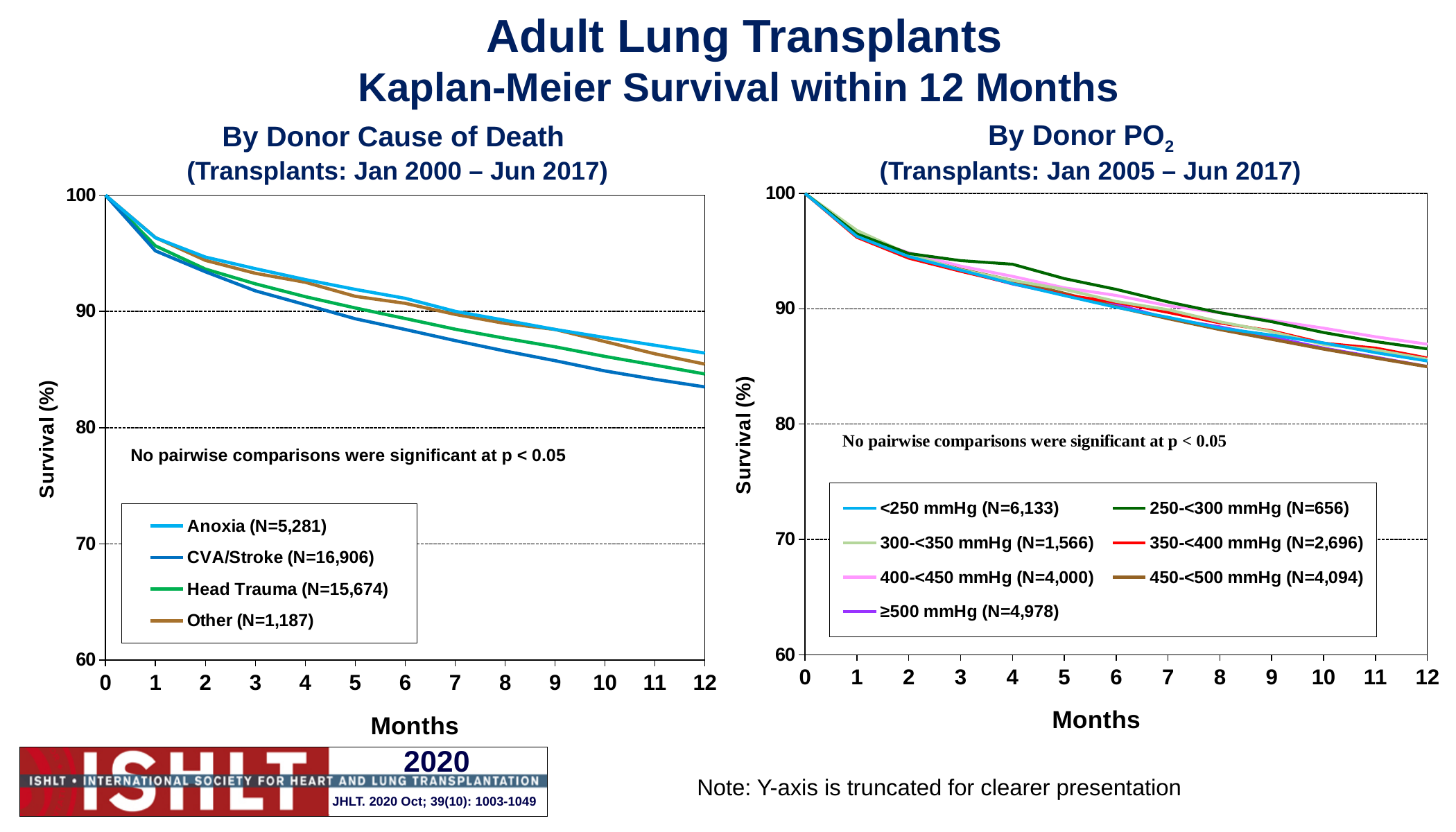
In the left chart, 'By Donor Cause of Death', which donor cause of death has the lowest survival at 12 months? CVA/Stroke How many series does the legend of the left chart, 'By Donor Cause of Death', list? 4 In the right chart, 'By Donor PO2', is the survival for <250 mmHg at 12 months greater or less than 90? less In the right chart, 'By Donor PO2', is the survival for 250-<300 mmHg at 4 months greater or less than 90? greater In the left chart, 'By Donor Cause of Death', which is higher at 12 months: Anoxia or CVA/Stroke? Anoxia In the left chart, 'By Donor Cause of Death', is the survival for CVA/Stroke at 12 months greater or less than 90? less In the right chart, 'By Donor PO2', do the survival curves rise or fall as months increase? Fall What kind of chart is the left chart, 'By Donor Cause of Death'? Line chart In the left chart, 'By Donor Cause of Death', what is the N for CVA/Stroke shown in the legend? 16,906 How many series does the legend of the right chart, 'By Donor PO2', list? 7